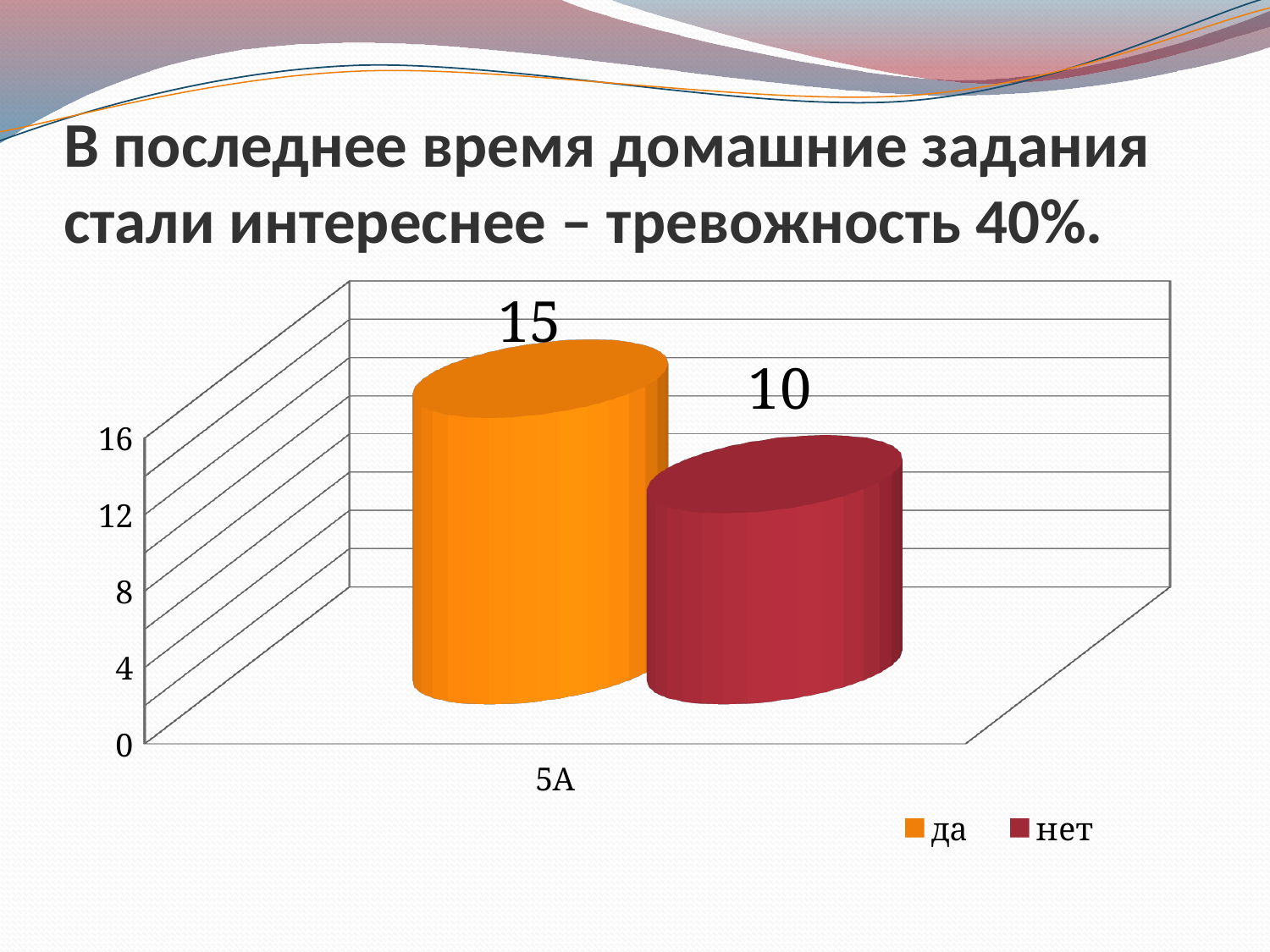
How many series does the legend list? 2 Which series has the higher value for 5А, "да" or "нет"? да What is the label of the category on the x axis? 5А Is the value for "нет" greater or less than 12? less What colour is the bar for the "нет" series? dark red What is the value for "да" in category 5А? 15 Which series has the lowest value in the chart? нет What is the difference between the values for "да" and "нет"? 5 Is the value for "да" greater or less than 12? greater What is the value for "нет" in category 5А? 10 How many categories are shown on the x axis? 1 What kind of chart is shown on the slide? bar chart